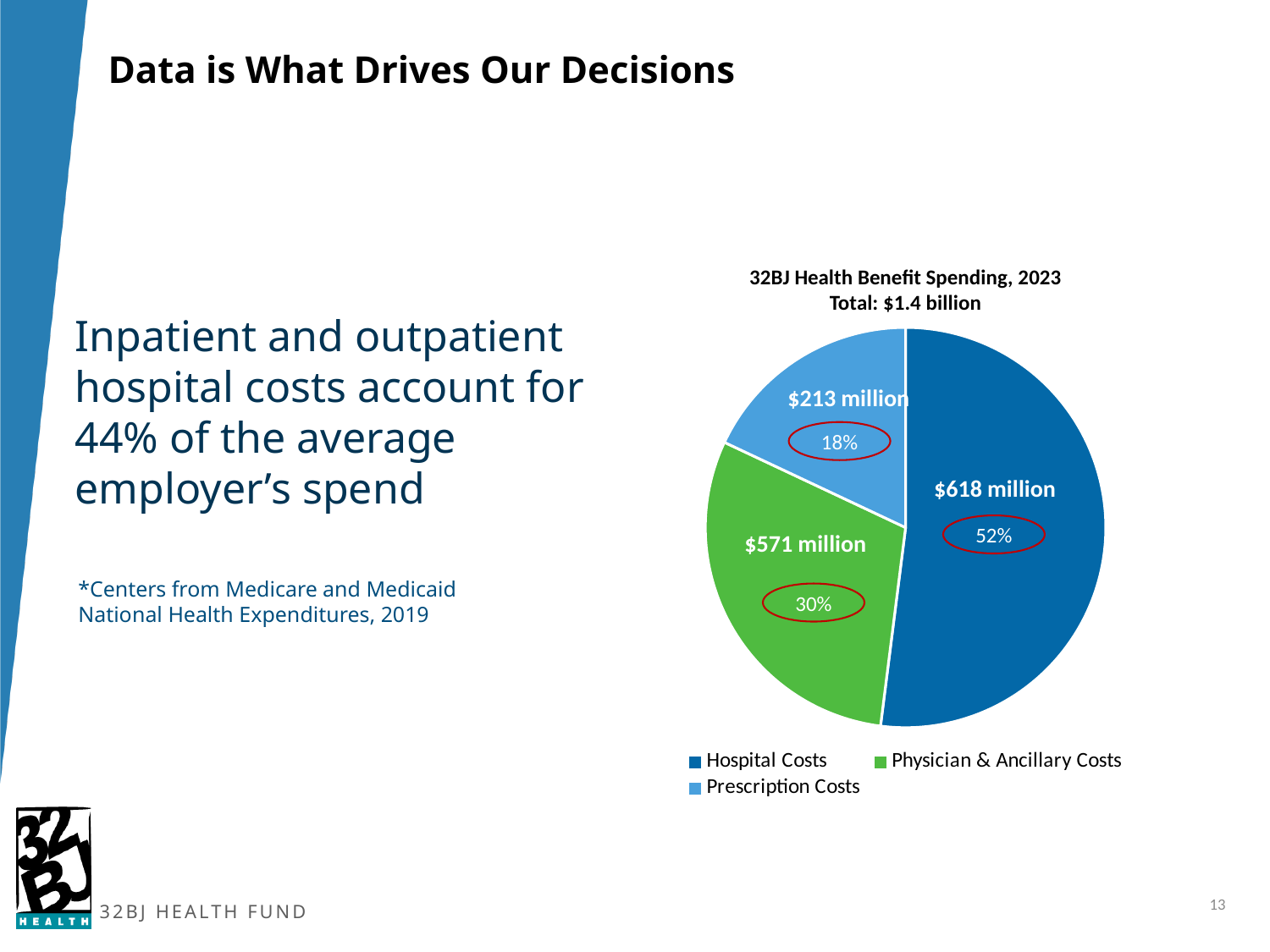
What is the value for Prescription Costs? $213 million How many slices does the pie chart have? 3 What is the title of the chart? 32BJ Health Benefit Spending, 2023 Total: $1.4 billion What is the value for Hospital Costs? $618 million What is the difference in dollars between Hospital Costs and Prescription Costs? $405 million What is the value for Physician & Ancillary Costs? $571 million Which category has the smallest share of spending? Prescription Costs Which is larger, Physician & Ancillary Costs or Prescription Costs? Physician & Ancillary Costs What share of the pie is Physician & Ancillary Costs? 30% What kind of chart is shown on the slide? pie chart Which category has the largest share of spending? Hospital Costs How many entries does the legend list? 3